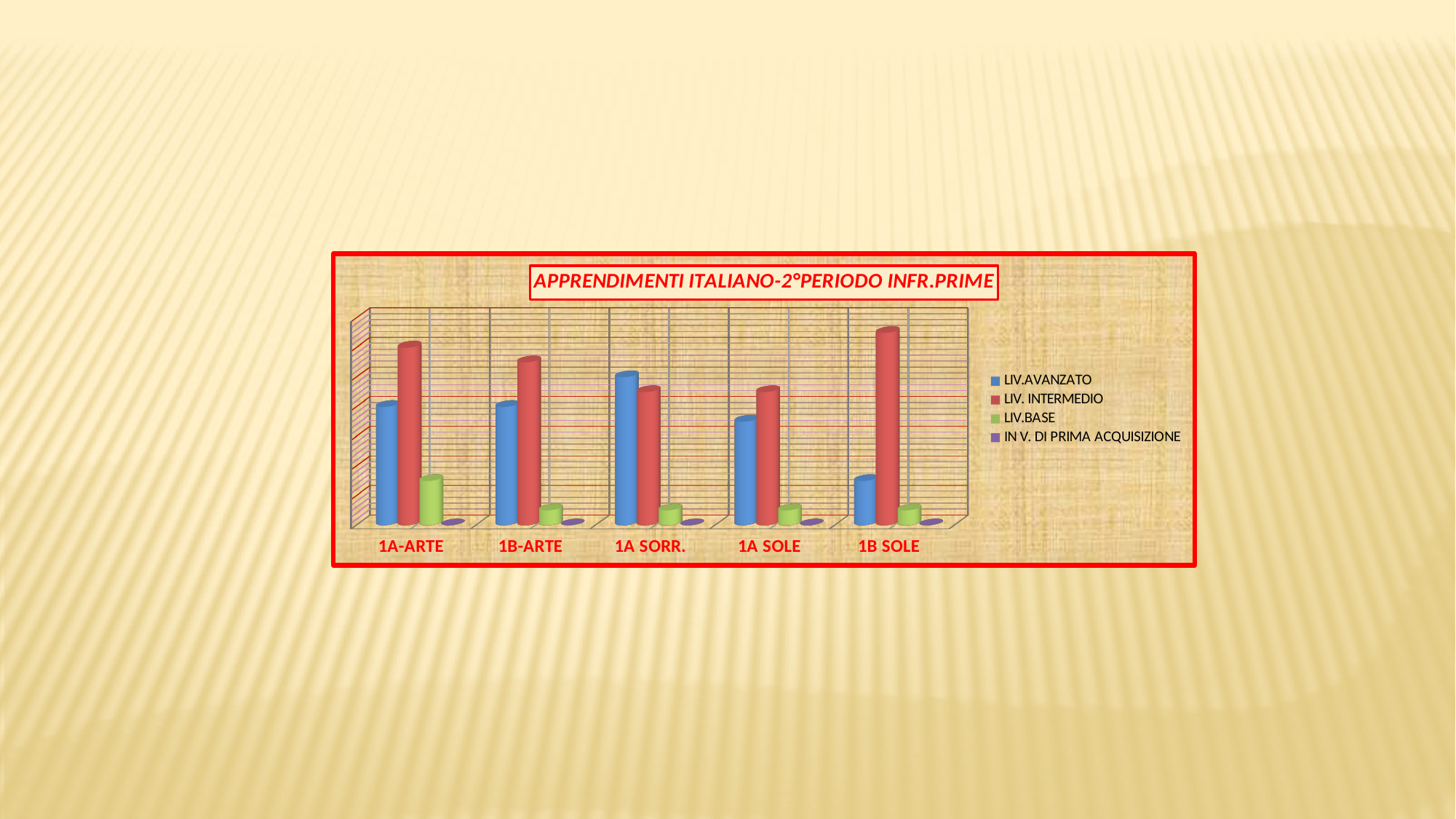
What kind of chart is shown on the slide? Bar chart For 1A-ARTE, which is larger: LIV.AVANZATO or LIV.BASE? LIV.AVANZATO Which class has the lowest LIV.AVANZATO value? 1B SOLE Which class has the highest LIV. INTERMEDIO value? 1B SOLE What is the title of the chart? APPRENDIMENTI ITALIANO-2°PERIODO INFR.PRIME Which colour represents the LIV.BASE series in the legend? Green For 1B SOLE, which is larger: LIV.AVANZATO or LIV. INTERMEDIO? LIV. INTERMEDIO Which class has the highest LIV.AVANZATO value? 1A SORR. How many categories (classes) are shown along the x axis? 5 How many series does the legend list? 4 For 1A-ARTE, which is larger: LIV. INTERMEDIO or LIV.AVANZATO? LIV. INTERMEDIO Which class has the highest LIV.BASE value? 1A-ARTE